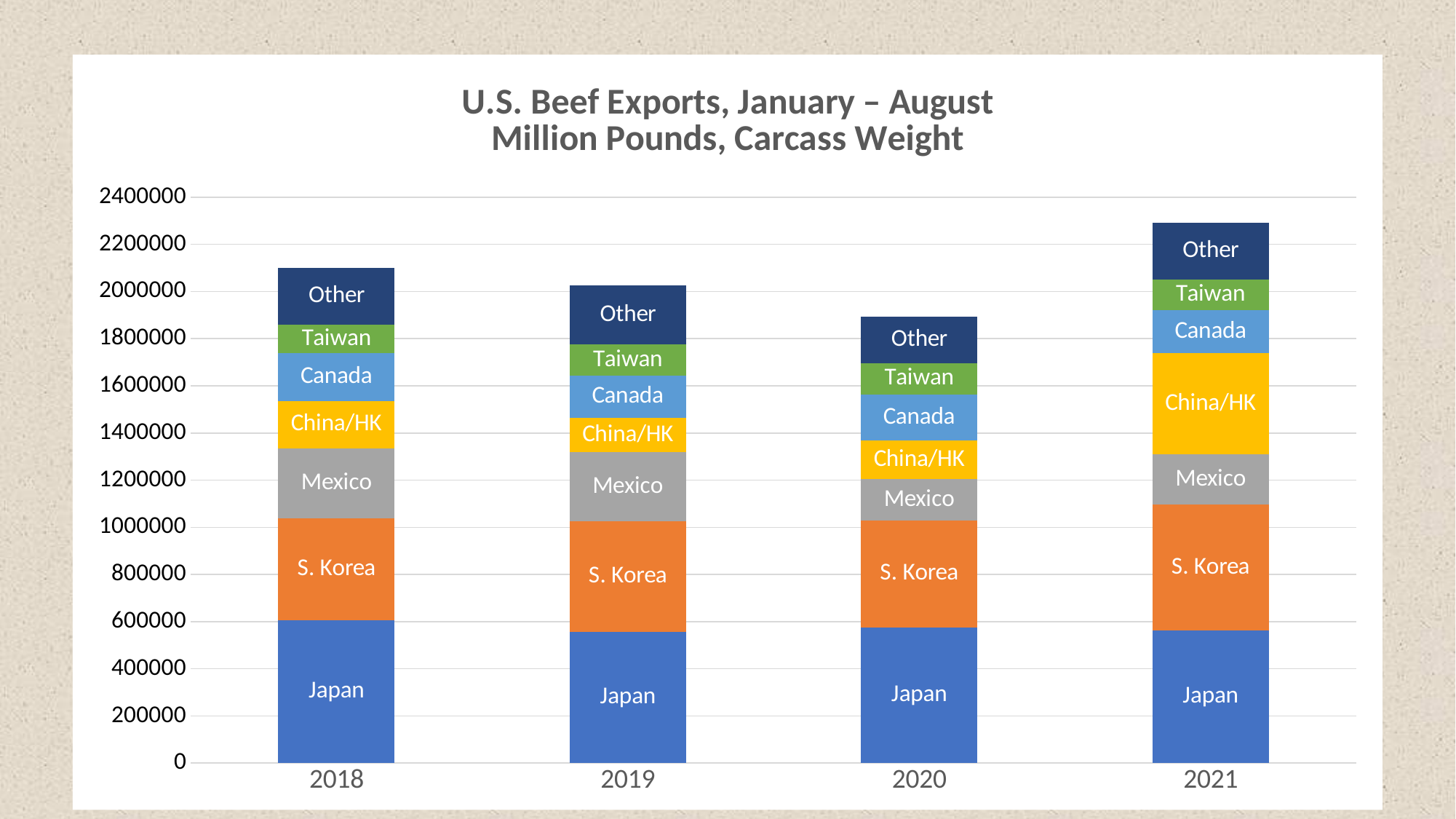
How many market segments make up each stacked bar? 7 Which market is the bottom segment of every bar? Japan In which year is the China/HK segment the largest? 2021 Which year has the larger total, 2020 or 2021? 2021 Is the total for 2020 greater or less than 2000000? less How many years are shown on the x axis? 4 Is the total for 2021 greater or less than 2200000? greater Is the total for 2018 greater or less than 2000000? greater Which year has the lowest total U.S. beef exports? 2020 Does the total rise or fall from 2020 to 2021? rise What kind of chart is shown on the slide? Stacked bar chart Which year has the highest total U.S. beef exports? 2021